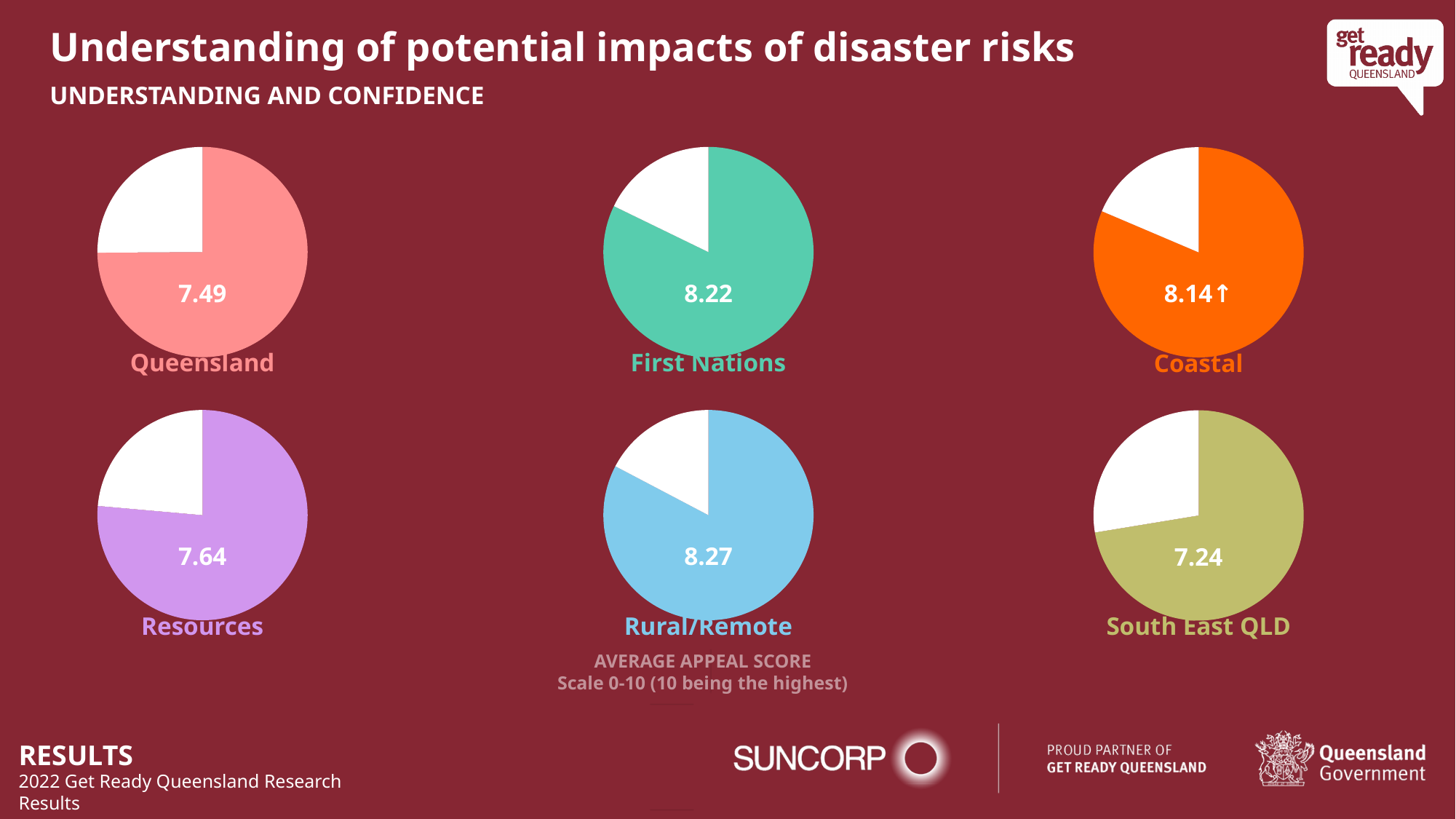
What is the average appeal score shown in the Coastal pie chart? 8.14 What is the average appeal score shown in the South East QLD pie chart? 7.24 What is the average appeal score shown in the First Nations pie chart? 8.22 How many pie charts are shown on the slide? 6 Which has the larger average appeal score, Resources or Queensland? Resources Which group has the lowest average appeal score across the six pie charts? South East QLD What is the average appeal score shown in the Queensland pie chart? 7.49 What is the average appeal score shown in the Resources pie chart? 7.64 What is the average appeal score shown in the Rural/Remote pie chart? 8.27 What is the difference between the Rural/Remote score and the South East QLD score? 1.03 What type of chart is used to show the Coastal score? Pie chart Which group has the highest average appeal score across the six pie charts? Rural/Remote